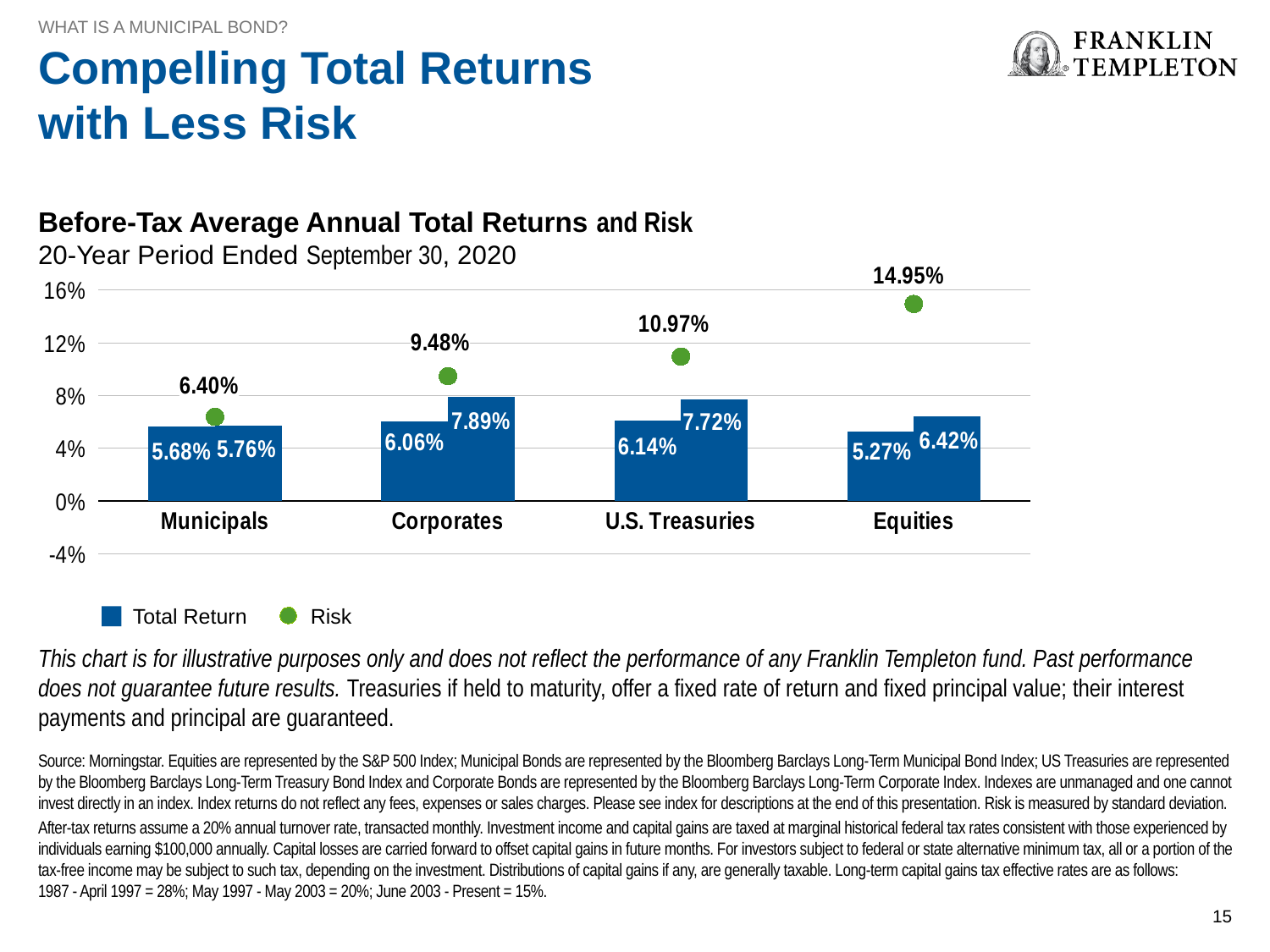
Which category has the lowest Risk value? Municipals How many series does the legend list? 2 What is the value labelled on the left-hand bar for Equities? 5.27% What is the value labelled on the right-hand bar for Corporates? 7.89% What is the difference between the Risk value for Equities and the Risk value for Municipals? 8.55% What is the Risk value shown for Municipals? 6.40% How many categories are shown on the x axis? 4 Which is larger, the Risk value for Corporates or the Risk value for U.S. Treasuries? U.S. Treasuries What is the Risk value shown for U.S. Treasuries? 10.97% Which category has the highest Risk value? Equities What is the Risk value shown for Equities? 14.95% What is the Risk value shown for Corporates? 9.48%